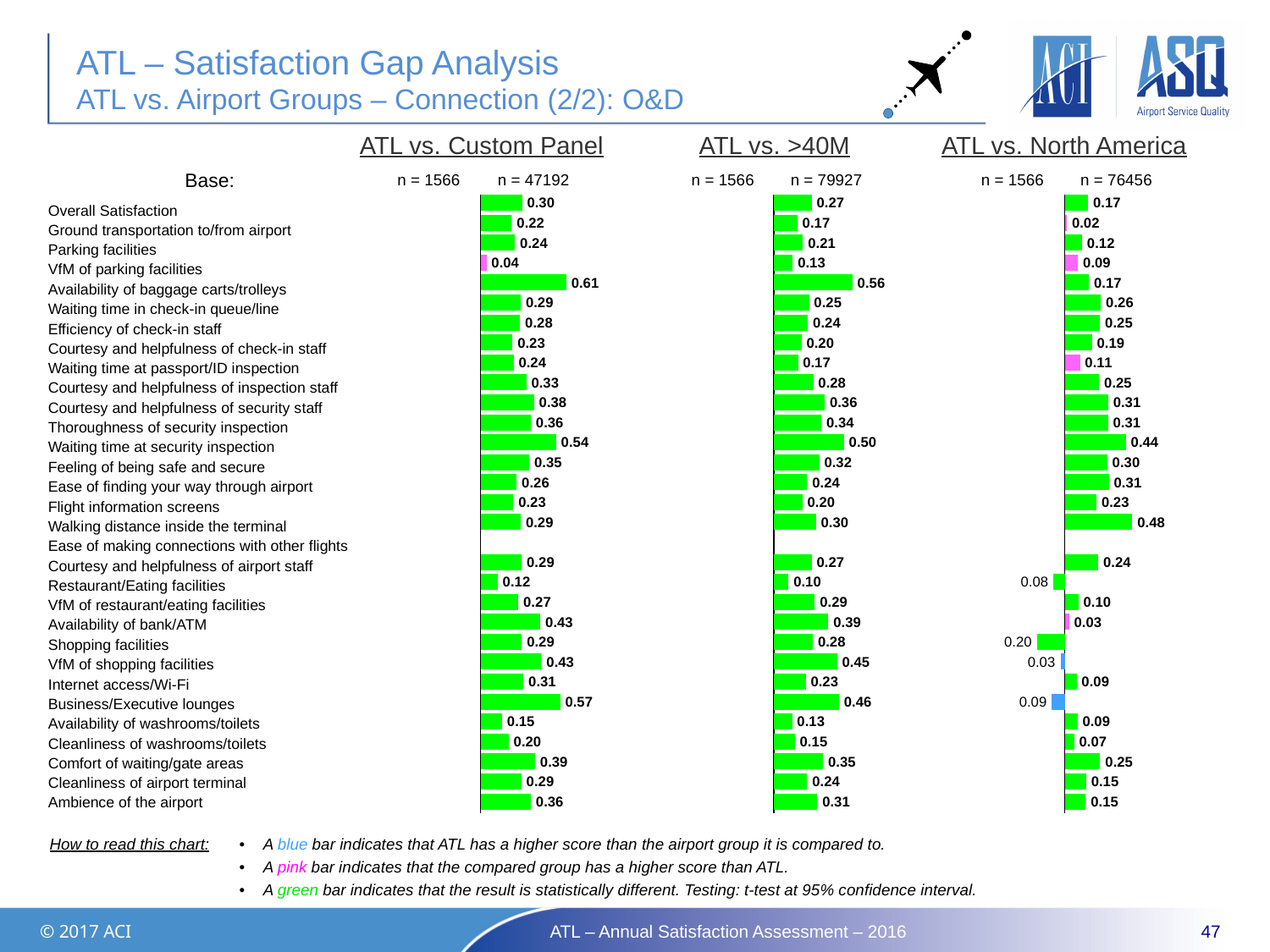
In the ATL vs. >40M chart, which is larger: Availability of bank/ATM or VfM of shopping facilities? VfM of shopping facilities In the ATL vs. North America chart, what colour is the bar for Business/Executive lounges? Blue In the ATL vs. >40M chart, what is the value for Overall Satisfaction? 0.27 In the ATL vs. Custom Panel chart, which item has the highest value? Availability of baggage carts/trolleys In the ATL vs. North America chart, which item has the highest value? Walking distance inside the terminal In the ATL vs. >40M chart, what is the value for Waiting time at security inspection? 0.50 In the ATL vs. Custom Panel chart, what is the difference between Business/Executive lounges and Restaurant/Eating facilities? 0.45 In the ATL vs. North America chart, what is the difference between Walking distance inside the terminal and Overall Satisfaction? 0.31 What kind of chart is used for the ATL vs. Custom Panel comparison? Bar chart In the ATL vs. North America chart, what is the value for Ground transportation to/from airport? 0.02 In the ATL vs. Custom Panel chart, which item has the lowest value? VfM of parking facilities In the ATL vs. Custom Panel chart, what is the value for Availability of baggage carts/trolleys? 0.61